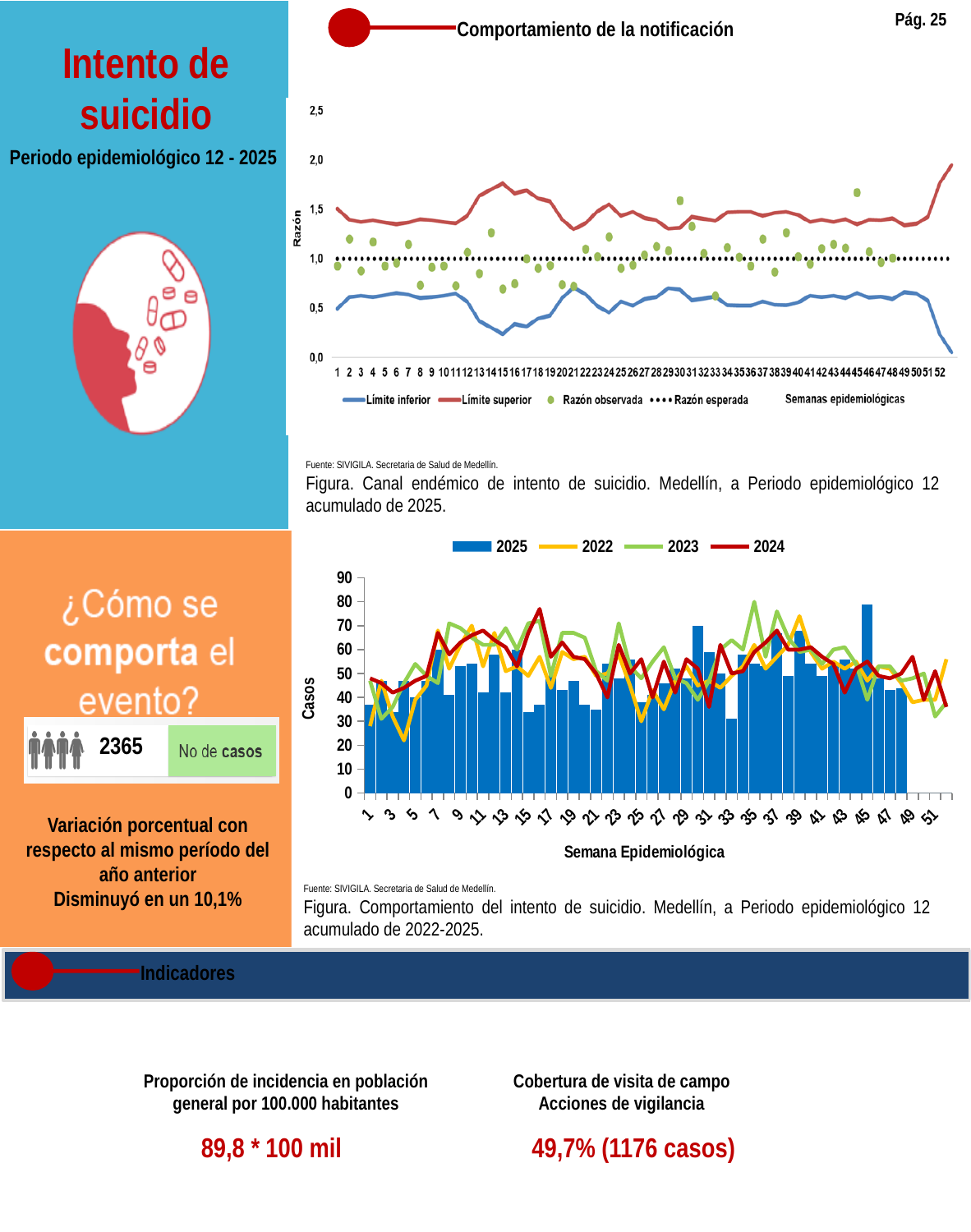
In the top chart (Canal endémico), is the Límite superior at week 52 greater or less than 1,5? greater In the top chart (Canal endémico), is the Límite inferior at week 15 greater or less than 0,5? less In the bottom chart (Comportamiento del intento de suicidio), which series is drawn as bars? 2025 In the bottom chart (Comportamiento del intento de suicidio), is the 2025 value at week 33 greater or less than 40? less In the top chart (Canal endémico), what colour is the Límite superior line? red In the top chart (Canal endémico), does the Límite superior rise or fall between week 49 and week 52? rise In the top chart (Canal endémico), how many series does the legend list? 4 In the top chart (Canal endémico), how many epidemiological weeks are shown on the x axis? 52 In the bottom chart (Comportamiento del intento de suicidio), how many series does the legend list? 4 In the top chart (Canal endémico), what value does the Razón esperada dotted line sit at? 1,0